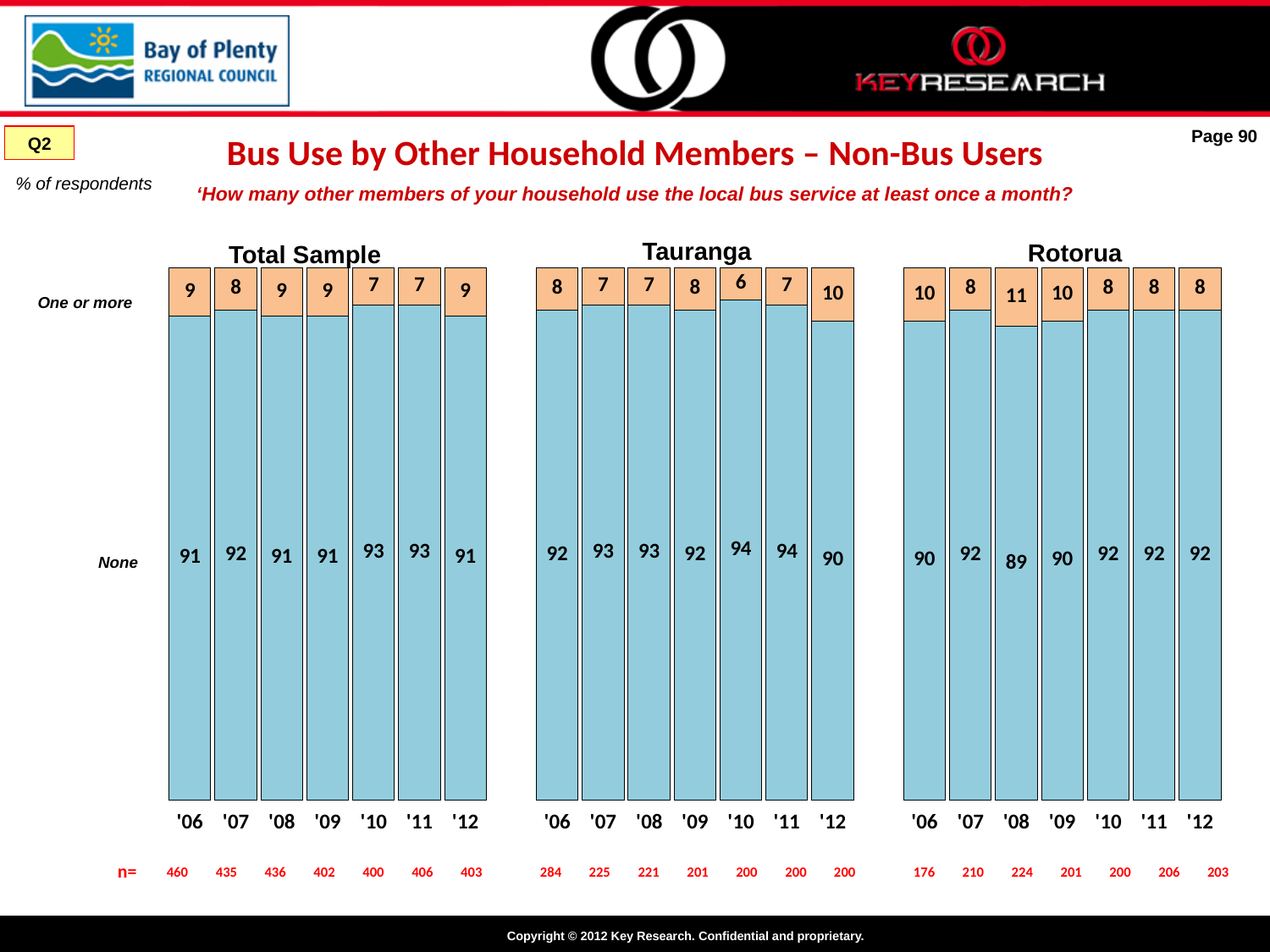
In the Tauranga chart, what is the difference between the 'None' value in '11 and the 'None' value in '12? 4 In the Rotorua chart, which is larger: the 'One or more' value in '06 or in '07? '06 In the Tauranga chart, which year has the lowest value for 'One or more'? '10 What type of chart is used for the Tauranga data? Stacked bar chart In the Total Sample chart, what is the value for 'None' in '10? 93 In the Rotorua chart, which year has the highest value for 'One or more'? '08 How many series are shown in each chart on the slide? 2 In the Total Sample chart, what is the total of the stacked bar for '07? 100 How many years are shown on the x axis of the Total Sample chart? 7 In the Tauranga chart, what is the value for 'One or more' in '12? 10 What is the sample size (n=) for Rotorua in '12? 203 In the Rotorua chart, what is the value for 'None' in '08? 89